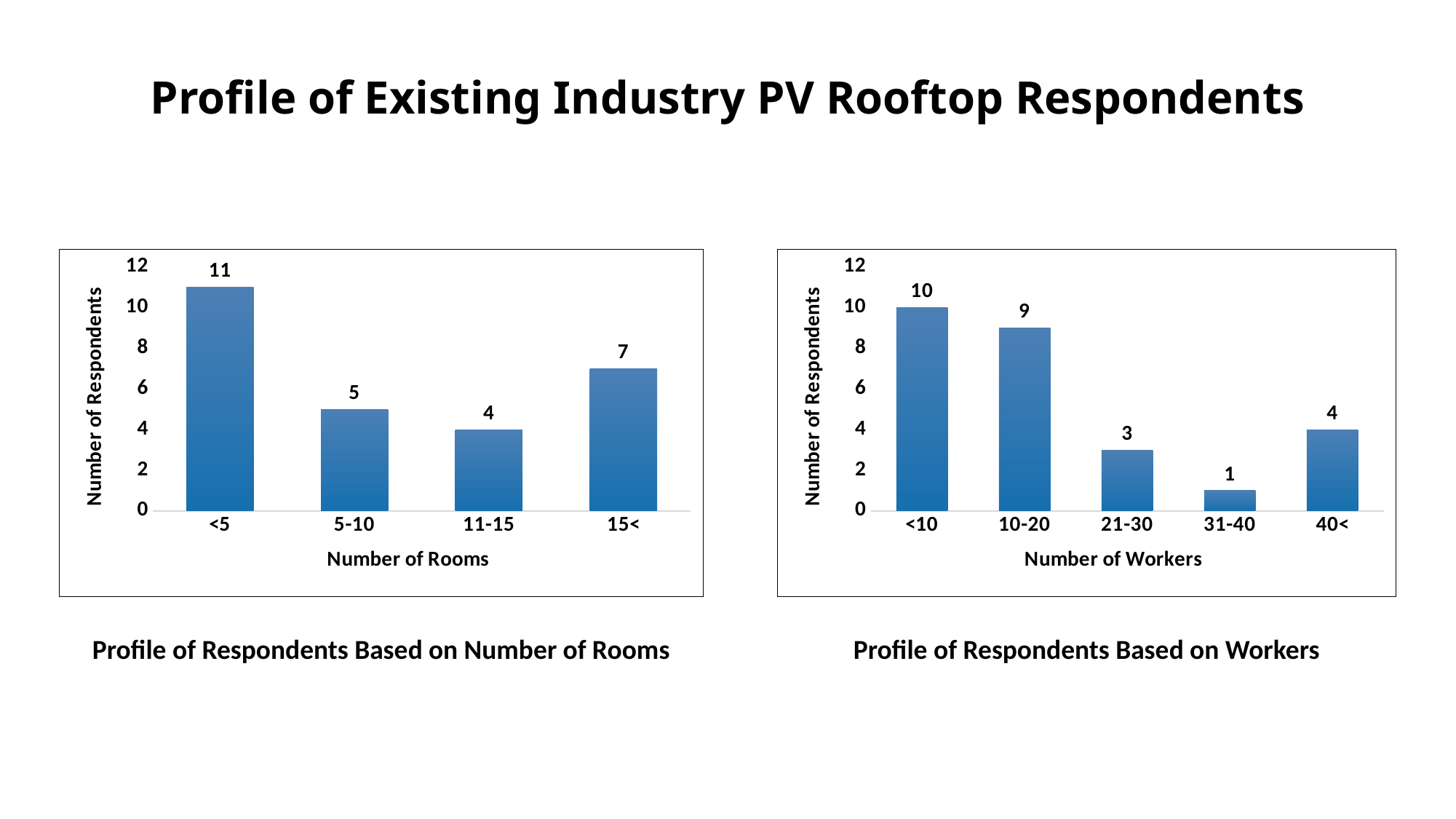
What type of chart is the 'Profile of Respondents Based on Workers' chart? Bar chart In the 'Profile of Respondents Based on Number of Rooms' chart, which category has the lowest number of respondents? 11-15 In the 'Profile of Respondents Based on Number of Rooms' chart, how many respondents are in the 11-15 rooms category? 4 In the 'Profile of Respondents Based on Number of Rooms' chart, what is the difference in respondents between the <5 and 15< categories? 4 In the 'Profile of Respondents Based on Workers' chart, how many worker categories are shown on the x axis? 5 In the 'Profile of Respondents Based on Number of Rooms' chart, how many respondents have fewer than 5 rooms (<5)? 11 In the 'Profile of Respondents Based on Workers' chart, how many respondents have 10-20 workers? 9 In the 'Profile of Respondents Based on Workers' chart, which category has the highest number of respondents? <10 In the 'Profile of Respondents Based on Number of Rooms' chart, which category has the highest number of respondents? <5 In the 'Profile of Respondents Based on Workers' chart, which is larger: the value for 21-30 workers or the value for 40< workers? 40< In the 'Profile of Respondents Based on Workers' chart, how many respondents have 31-40 workers? 1 In the 'Profile of Respondents Based on Number of Rooms' chart, how many room categories are shown on the x axis? 4